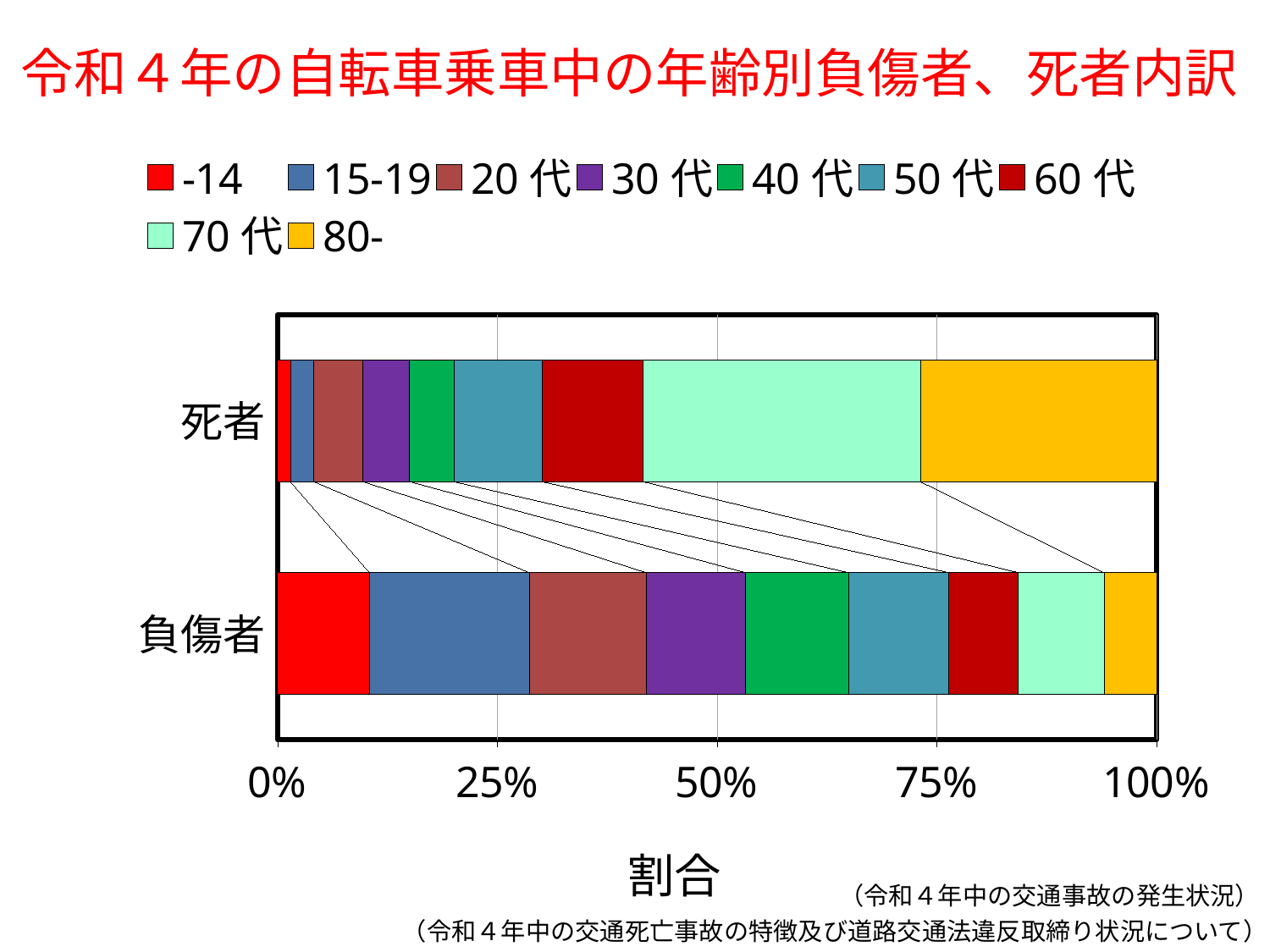
What is the label of the horizontal axis? 割合 Which age group has the largest share in the 死者 bar? 70 代 Which age group has the largest share in the 負傷者 bar? 15-19 What is the title of the chart? 令和４年の自転車乗車中の年齢別負傷者、死者内訳 How many series does the legend list? 9 Which age group has the smallest share in the 死者 bar? -14 Is the share of 70 代 in the 死者 bar greater or less than 25%? greater Which age group has the smallest share in the 負傷者 bar? 80- Is the share of -14 larger in the 死者 bar or the 負傷者 bar? 負傷者 What kind of chart is shown on the slide? Stacked bar chart How many categories (bars) are plotted on the chart? 2 Is the share of 80- larger in the 死者 bar or the 負傷者 bar? 死者